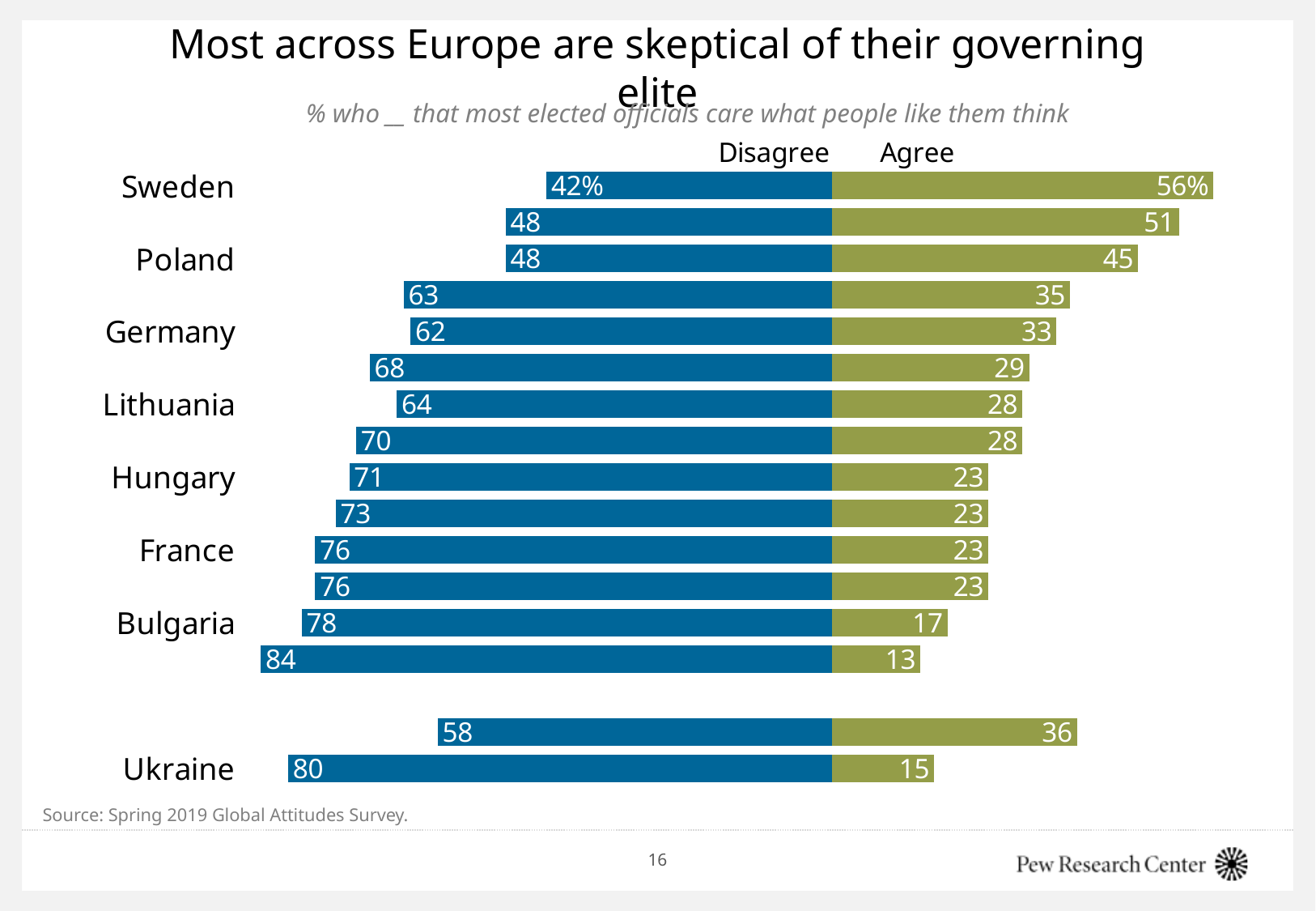
Which has the larger Agree value, Sweden or Ukraine? Sweden What is the Disagree value for Poland? 48 What is the difference between the Disagree and Agree values for Bulgaria? 61 What is the difference between the Agree and Disagree values for Sweden? 14 What is the Agree value for Germany? 33 What is the Agree value for Sweden? 56% What is the Agree value for Ukraine? 15 Which has the larger Disagree value, Hungary or France? France What percentage of people in Sweden disagree that most elected officials care what people like them think? 42% What type of chart is shown on the slide? Bar chart What is the Disagree value for Bulgaria? 78 How many series does the chart show? 2